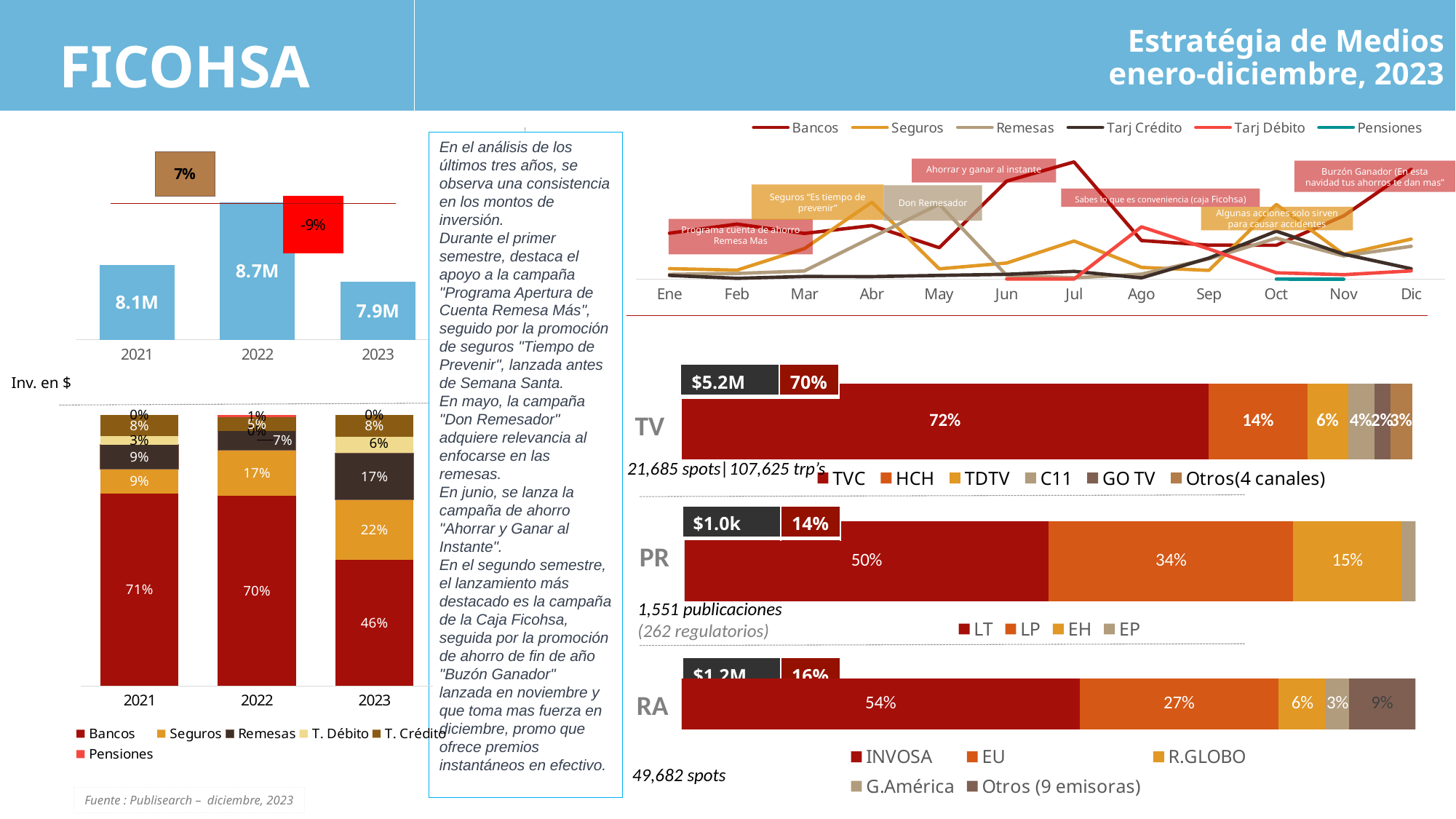
In the bottom-left stacked bar chart, what is the share of Bancos in 2023? 46% In the top-left bar chart of investment by year, how many years are shown? 3 In the bottom-left stacked bar chart, does the share of Bancos rise or fall from 2021 to 2023? fall In the bottom-left stacked bar chart, what is the share of Seguros in 2022? 17% In the top-left bar chart of investment by year, which year has the lowest investment? 2023 In the PR horizontal stacked bar, what is the difference between the LT and LP shares? 16% In the RA horizontal stacked bar, which station has the largest share? INVOSA In the top-left bar chart of investment by year, what percentage change is shown for 2023? -9% In the bottom-left stacked bar chart, how many series does the legend list? 6 In the top-left bar chart of investment by year, what is the value for 2022? 8.7M In the top-right line chart, how many series does the legend list? 6 In the TV horizontal stacked bar, what is the share for HCH? 14%